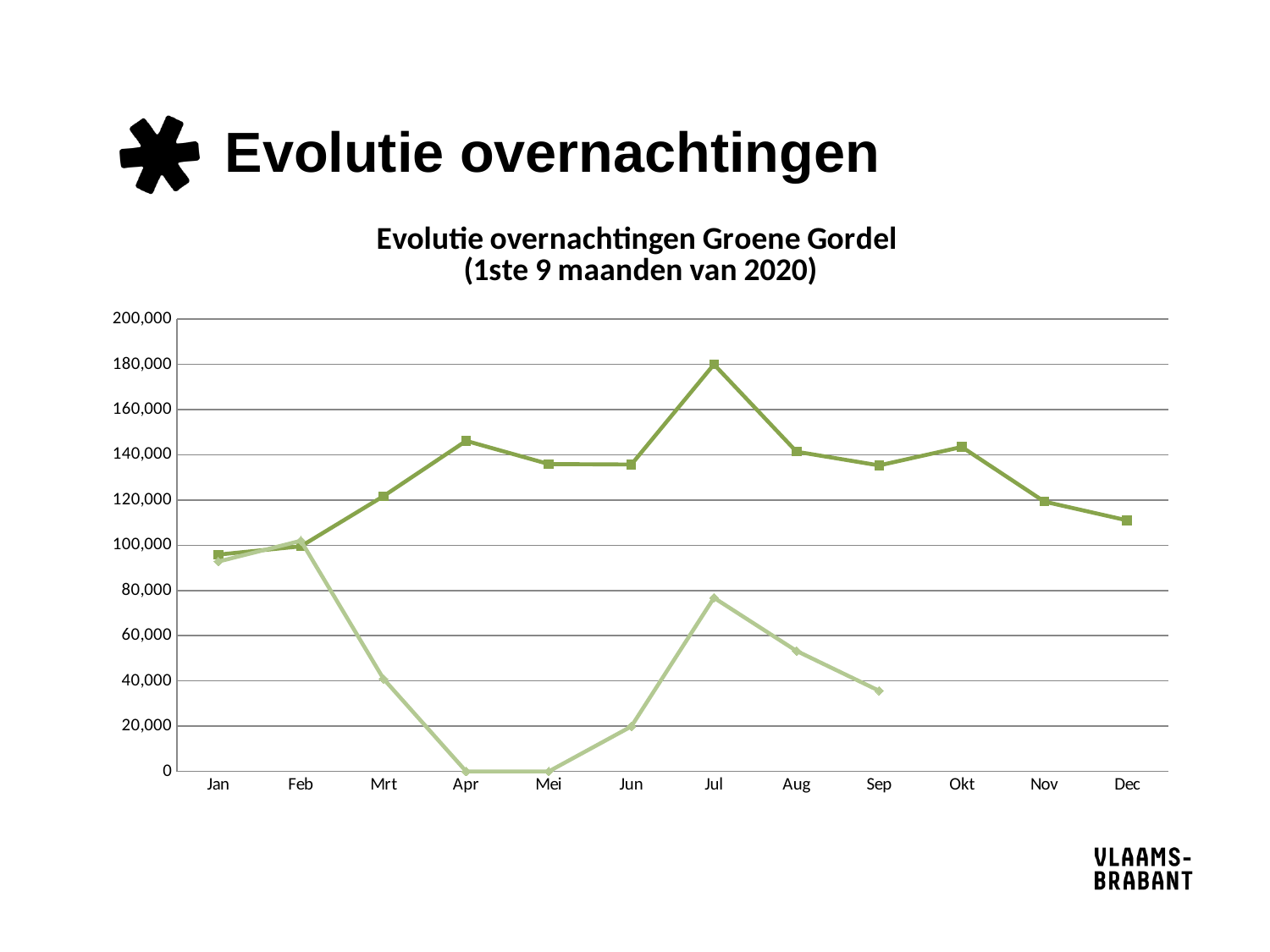
Is the value of the darker green line with square markers in Apr greater or less than 140,000? greater What is the value of the lighter green line with diamond markers in Apr? 0 Does the lighter green line with diamond markers rise or fall from Feb to Apr? fall What is the value of the lighter green line with diamond markers in Mei? 0 Is the value of the lighter green line with diamond markers in Mrt greater or less than 60,000? less Is the value of the darker green line with square markers in Jul greater or less than 160,000? greater What kind of chart is shown on the slide? line chart In which month does the darker green line with square markers have its lowest value? Jan How many months are shown on the x axis of the chart? 12 For the darker green line with square markers, which month has the larger value, Jul or Aug? Jul What is the title of the chart? Evolutie overnachtingen Groene Gordel (1ste 9 maanden van 2020) In which month does the darker green line with square markers reach its highest value? Jul